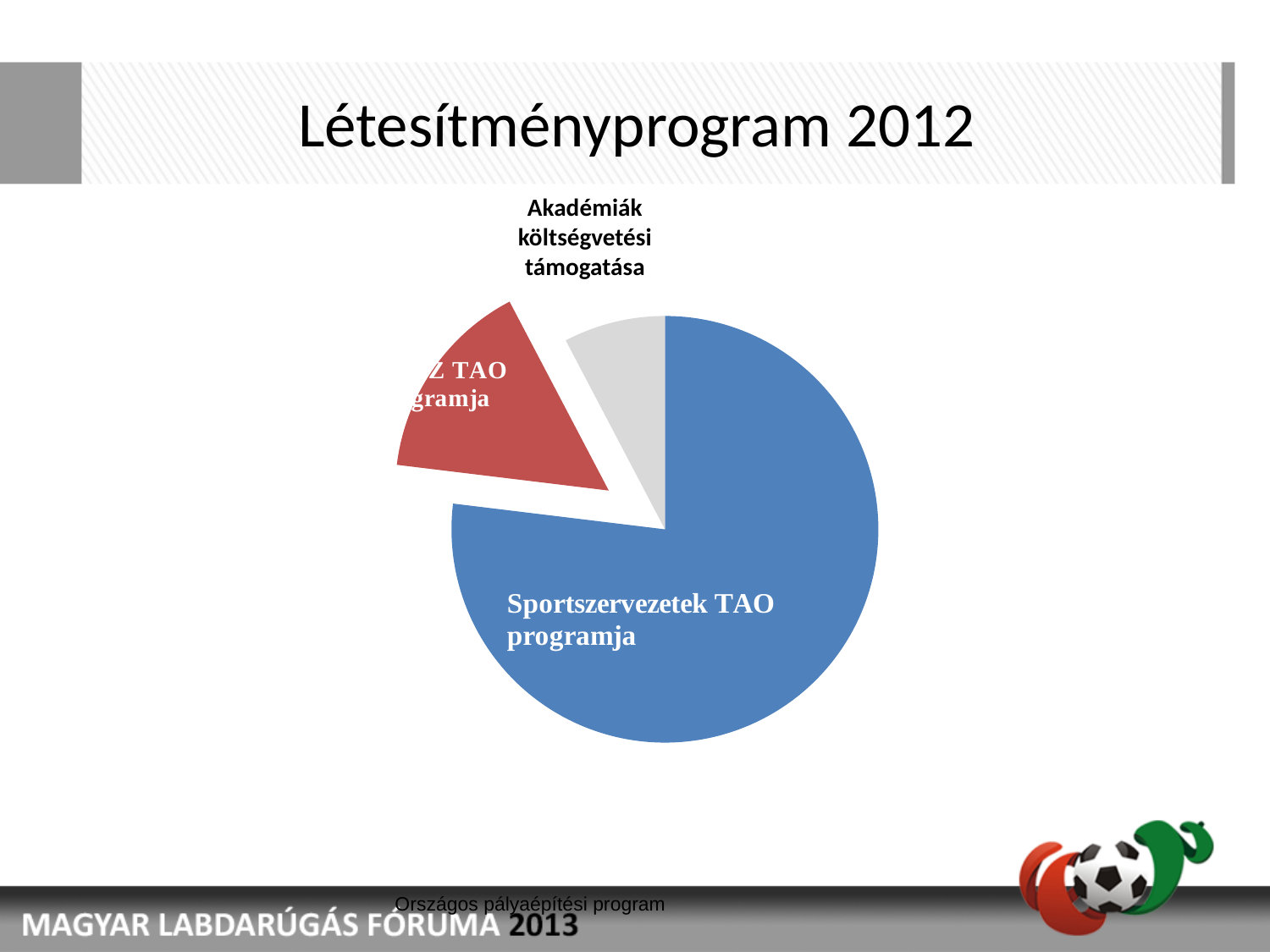
Which slice is larger: Sportszervezetek TAO programja or Akadémiák költségvetési támogatása? Sportszervezetek TAO programja What colour is the Sportszervezetek TAO programja slice? blue Which slice is larger: the red slice or the grey slice (Akadémiák költségvetési támogatása)? the red slice Which category has the smallest slice of the pie chart? Akadémiák költségvetési támogatása What kind of chart is shown on the slide? pie chart What is the title of the slide containing the pie chart? Létesítményprogram 2012 How many slices does the pie chart have? 3 Which category has the largest slice of the pie chart? Sportszervezetek TAO programja Does the Sportszervezetek TAO programja slice take up more or less than half of the pie? more